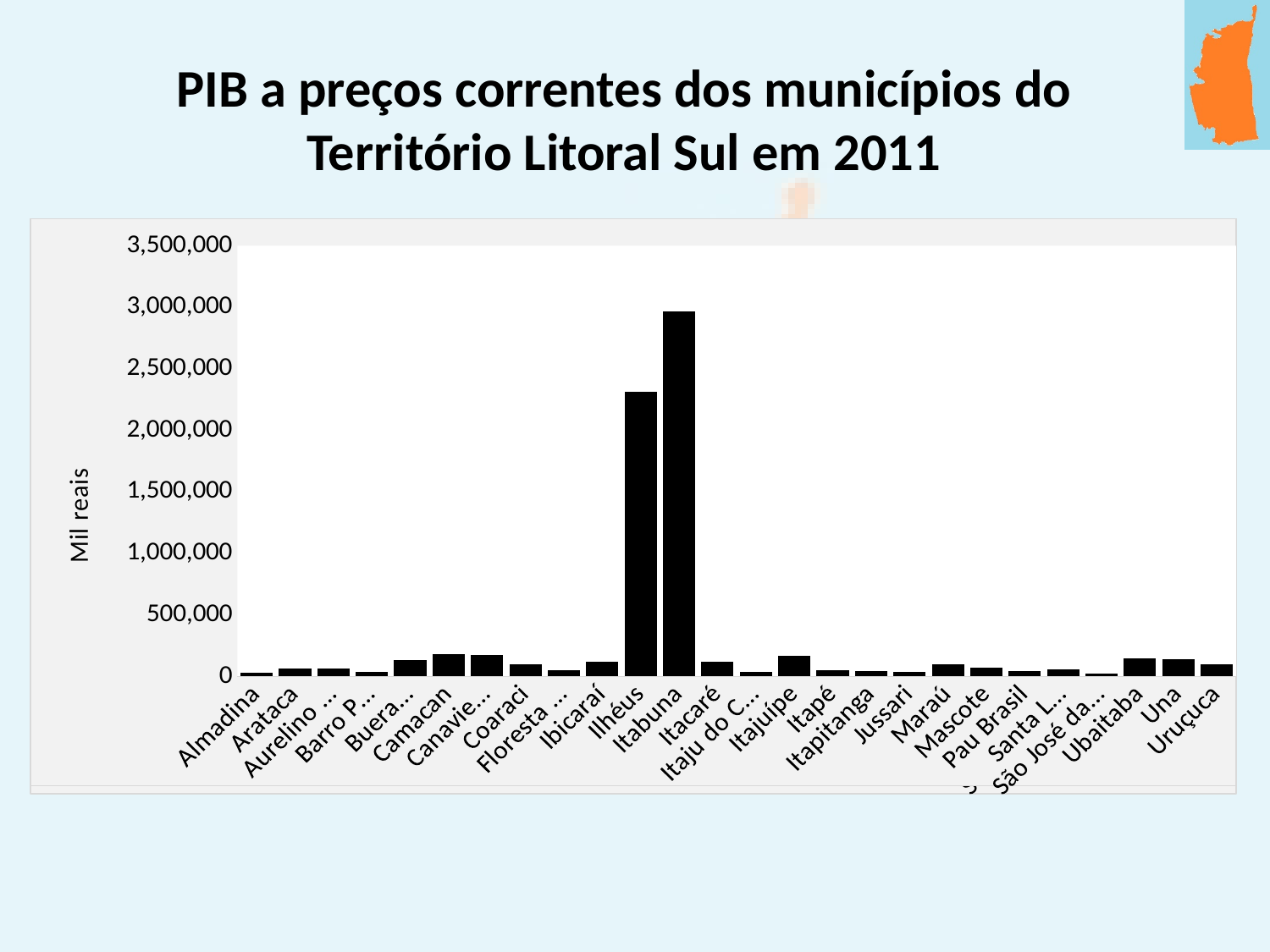
Which municipality has the highest PIB in the chart? Itabuna How many municipalities are shown on the x axis of the chart? 26 Is the value for Camacan greater or less than 500,000? less What kind of chart is shown on the slide? bar chart Is the value for Itabuna greater or less than 2,500,000? greater Is the value for Ilhéus greater or less than 2,500,000? less Which has a larger PIB, Itabuna or Ilhéus? Itabuna Which has a larger PIB, Ilhéus or Itajuípe? Ilhéus What is the label of the vertical axis? Mil reais What is the title of the slide? PIB a preços correntes dos municípios do Território Litoral Sul em 2011